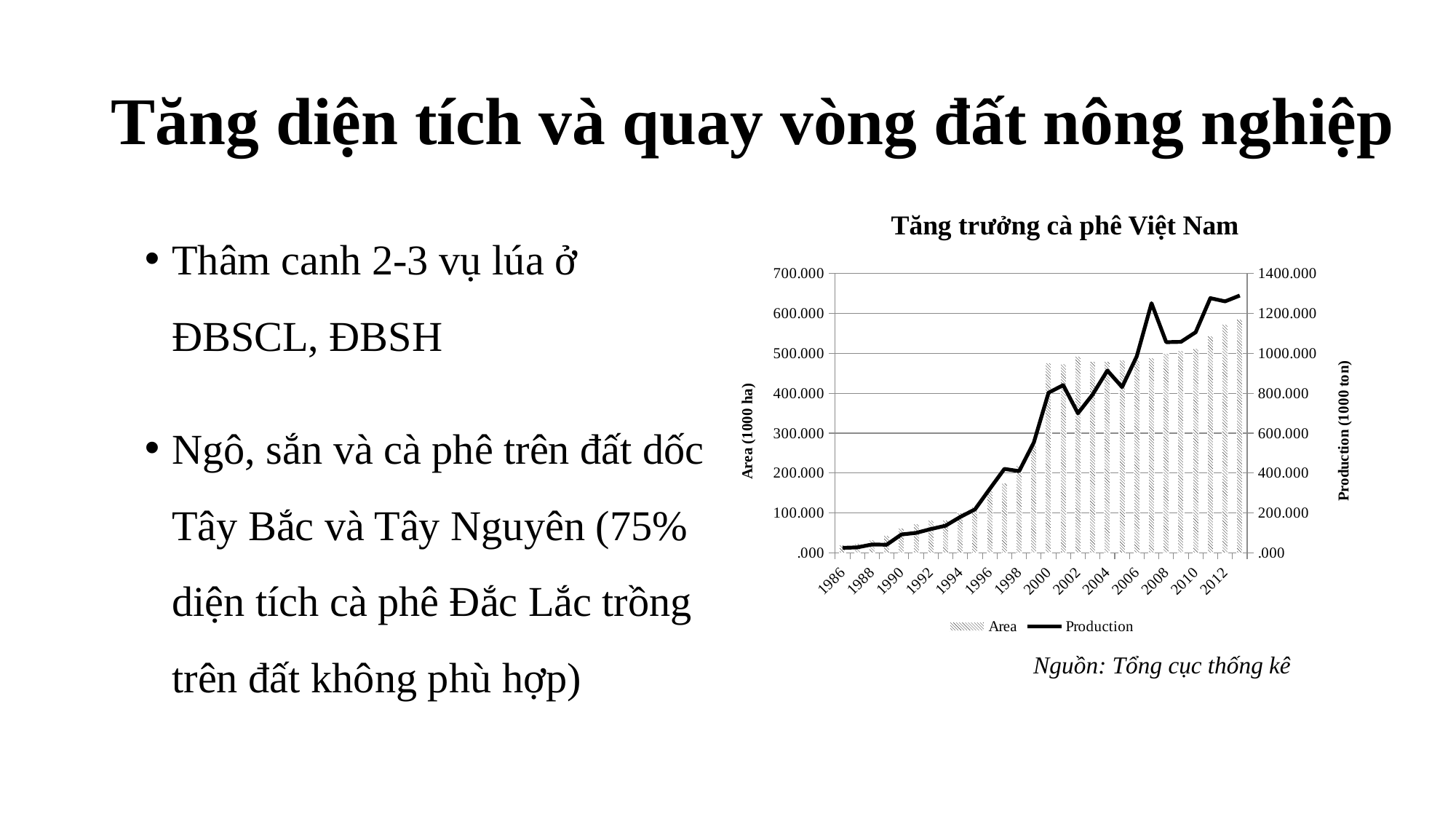
Is the Area value for 2000 greater or less than 400.000? greater Is the Production value for 2007 greater or less than 1000.000? greater Overall, does Production rise or fall from 1986 to 2013? rise What kind of chart is shown on the slide? A combined bar and line chart How many series does the chart's legend list? 2 Is the Production value for 1990 greater or less than 200.000? less What is the title of the chart on the slide? Tăng trưởng cà phê Việt Nam Which series is drawn as a line in the chart? Production In which year is the Area value lowest? 1986 Which year has the larger Production value, 2007 or 2008? 2007 In which year is the Area value highest? 2013